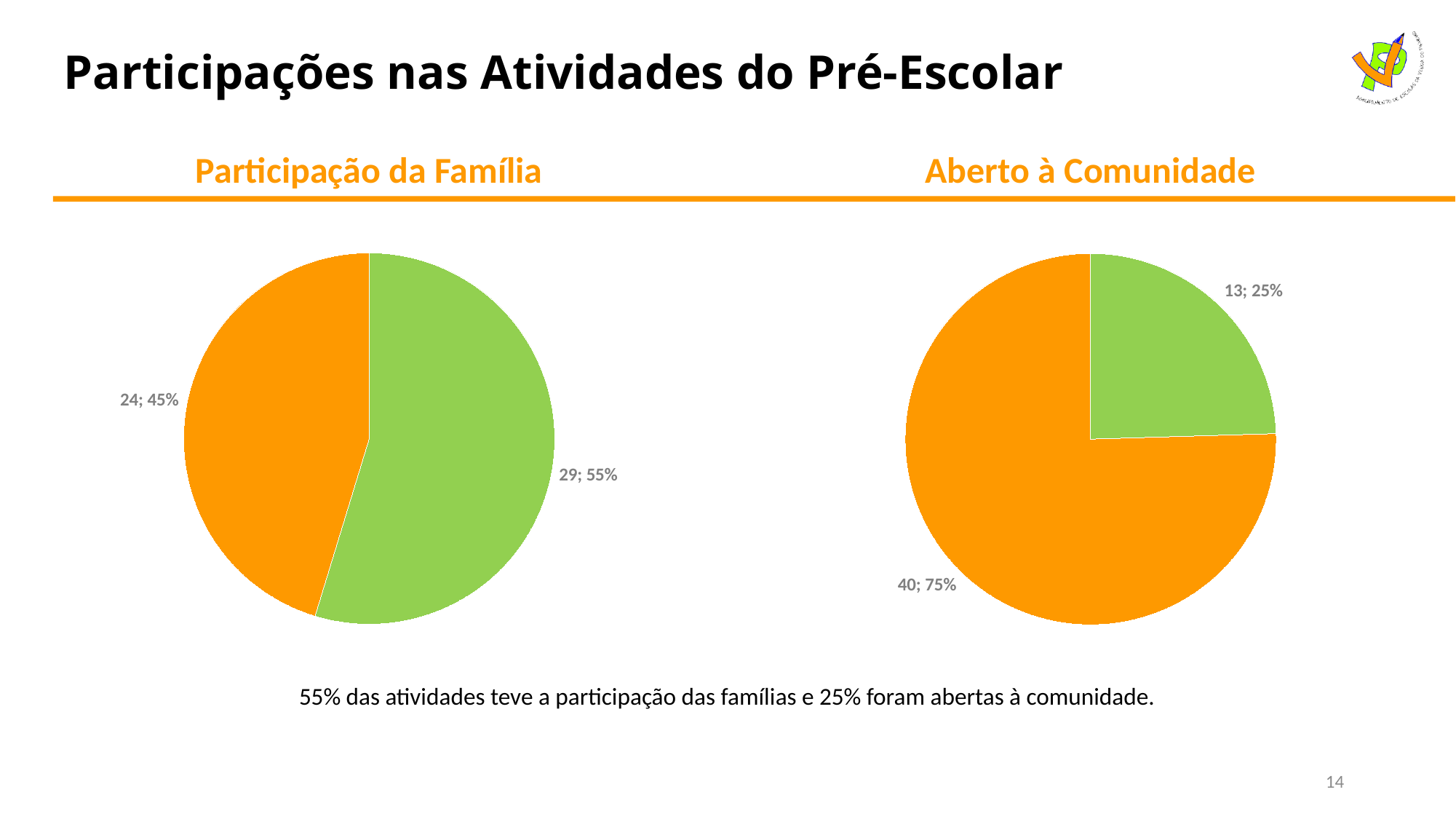
In the "Aberto à Comunidade" pie chart, which slice is the largest? orange In the "Aberto à Comunidade" pie chart, what value is shown on the orange slice? 40; 75% In the "Participação da Família" pie chart, what share of the pie does the green slice represent? 55% In the "Participação da Família" pie chart, what value is shown on the orange slice? 24; 45% How many slices does the "Aberto à Comunidade" pie chart have? 2 In the "Participação da Família" pie chart, which slice is larger, the green one or the orange one? green In the "Participação da Família" pie chart, what is the difference between the counts of the green slice and the orange slice? 5 What kind of chart is used under the heading "Participação da Família"? pie chart In the "Aberto à Comunidade" pie chart, what value is shown on the green slice? 13; 25% In the "Aberto à Comunidade" pie chart, what share of the pie does the green slice represent? 25% In the "Participação da Família" pie chart, what value is shown on the green slice? 29; 55% In the "Aberto à Comunidade" pie chart, what is the difference between the counts of the orange slice and the green slice? 27